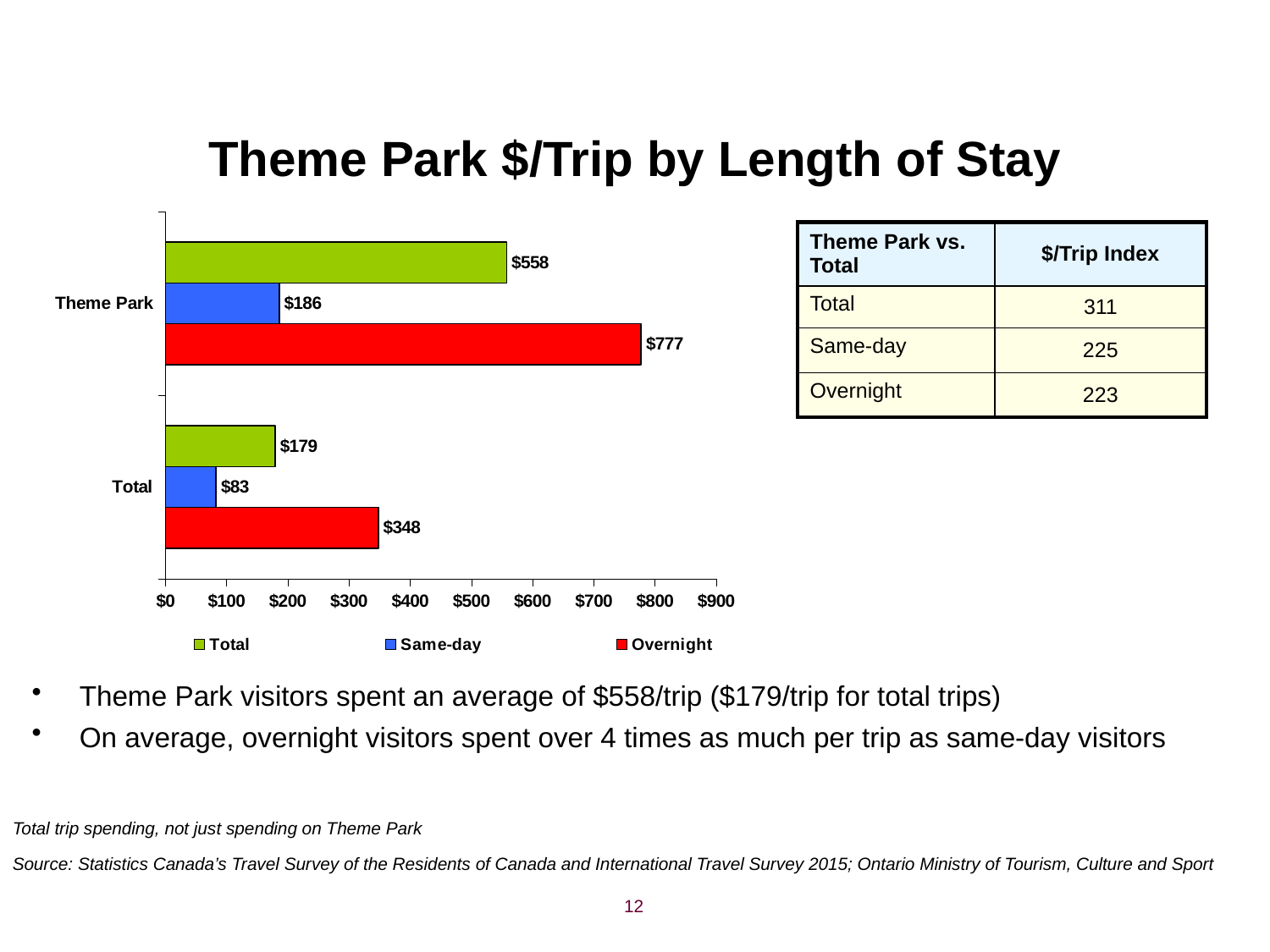
What is the difference between the Same-day and Overnight values for Theme Park? $591 Is the Overnight value for Theme Park greater or less than $700? greater What type of chart is shown on the slide? Bar chart Which series has the lowest value for the Total category? Same-day What is the Total series value for Theme Park? $558 Which is larger: the Total series value for Theme Park or the Overnight value for Total? Total series value for Theme Park What is the Same-day $/trip value for Total? $83 What is the difference between the Overnight values for Theme Park and Total? $429 How many series does the chart legend list? 3 How many categories are shown on the y axis of the chart? 2 Which series has the highest value for the Theme Park category? Overnight What is the Overnight $/trip value for Theme Park? $777